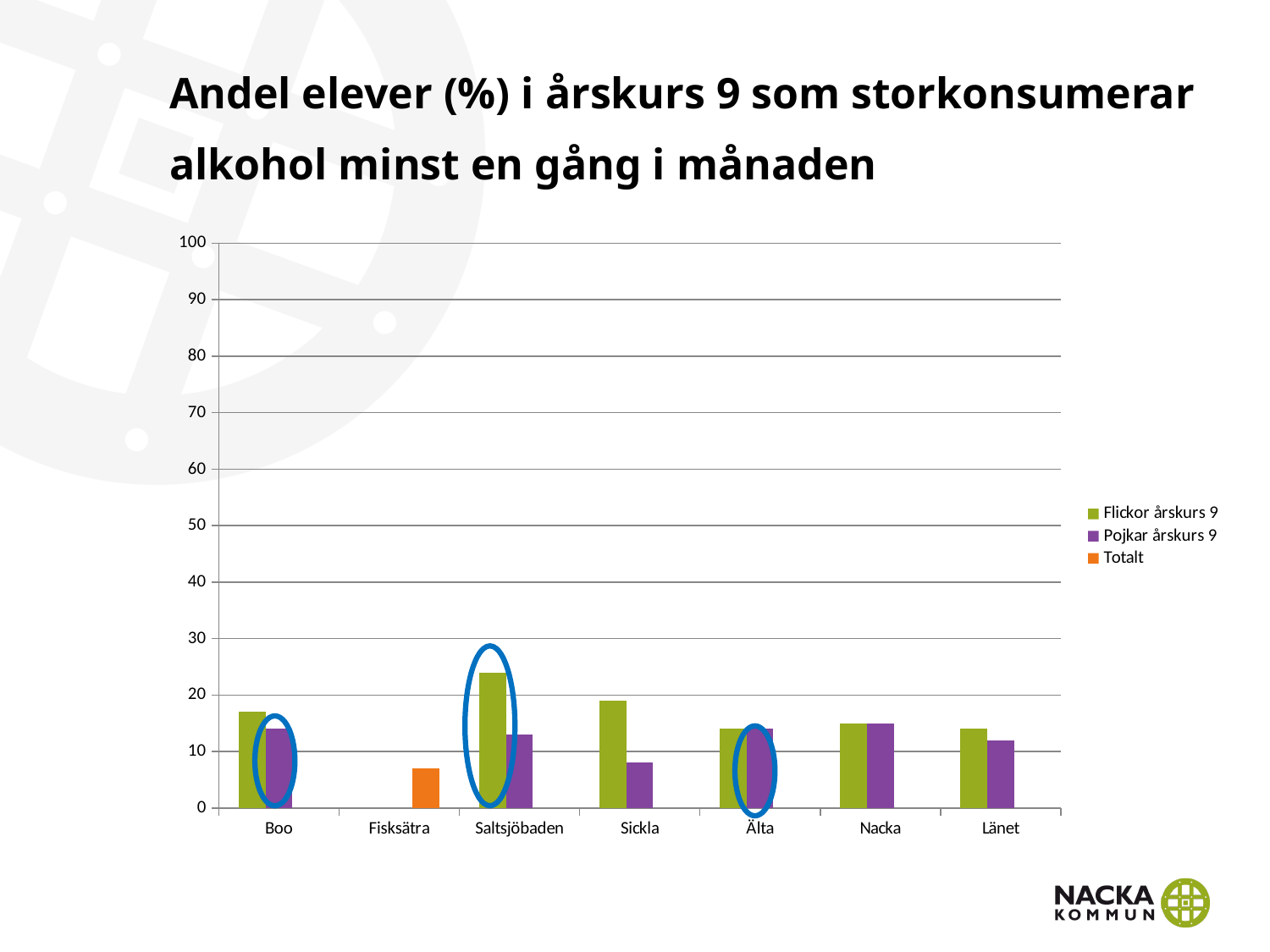
In Sickla, which is larger: Flickor årskurs 9 or Pojkar årskurs 9? Flickor årskurs 9 How many categories are shown on the x axis? 7 Is the value for Totalt in Fisksätra greater or less than 10? less Is the value for Flickor årskurs 9 in Saltsjöbaden greater or less than 20? greater What colour represents Pojkar årskurs 9 in the legend? purple Is the value for Pojkar årskurs 9 in Sickla greater or less than 10? less Which category shows only a Totalt bar and no Flickor or Pojkar bars? Fisksätra How many series does the legend list? 3 Which category has the highest value for Flickor årskurs 9? Saltsjöbaden Which category has the lowest value for Pojkar årskurs 9? Sickla What kind of chart is shown on the slide? bar chart